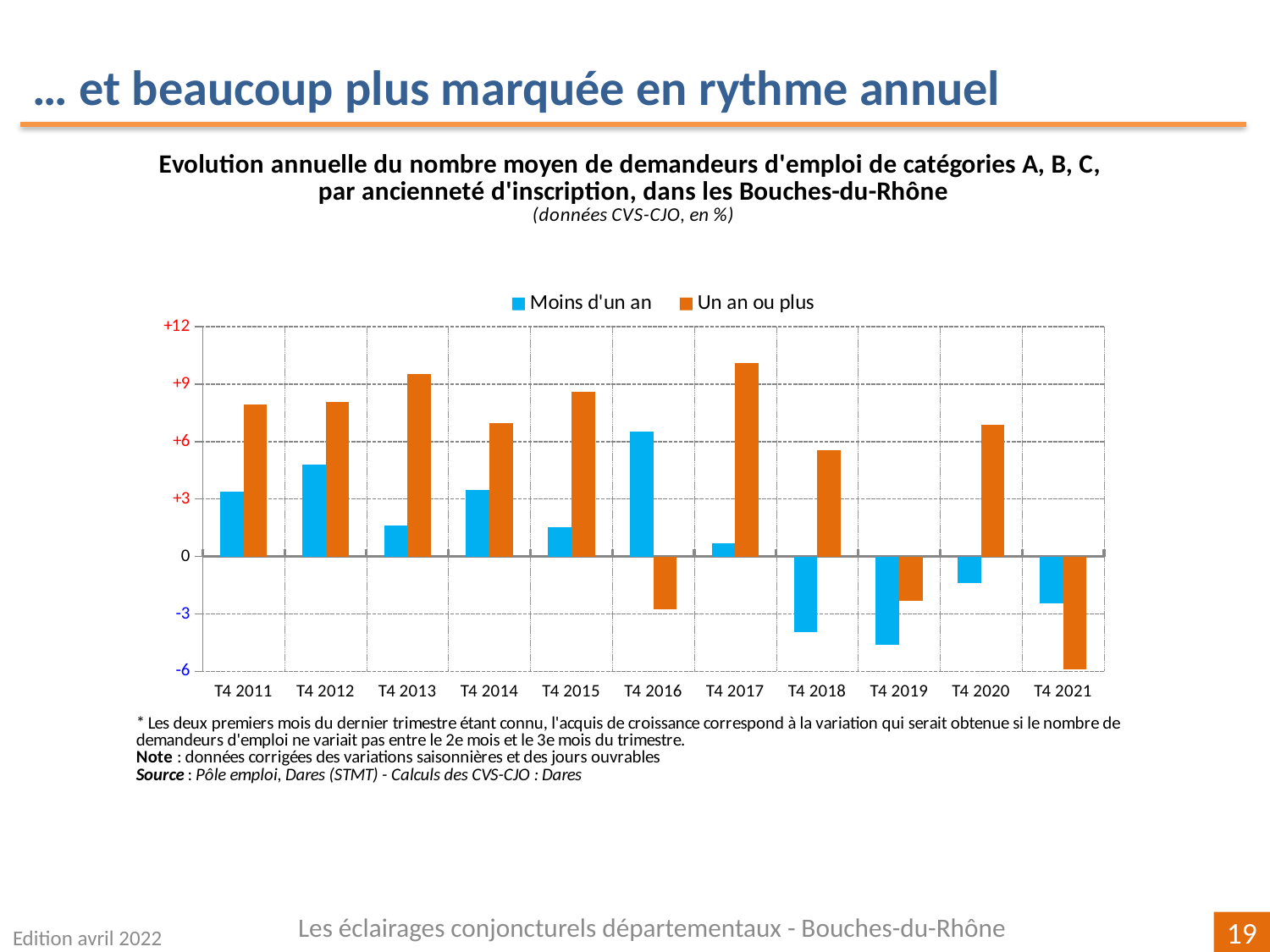
Is the value for 'Un an ou plus' in T4 2011 greater or less than +6? greater How many series does the legend list? 2 Is the value for 'Un an ou plus' in T4 2017 greater or less than +9? greater In which quarter does the 'Moins d'un an' series reach its highest value? T4 2016 In T4 2011, which series has the larger value, 'Moins d'un an' or 'Un an ou plus'? Un an ou plus Which series has the highest value in T4 2016, 'Moins d'un an' or 'Un an ou plus'? Moins d'un an What kind of chart is shown on the slide? bar chart Is the value for 'Un an ou plus' in T4 2021 greater or less than -3? less What are the two series names listed in the legend? Moins d'un an; Un an ou plus How many quarters (categories) are shown on the x axis? 11 In which quarter does the 'Moins d'un an' series reach its lowest value? T4 2019